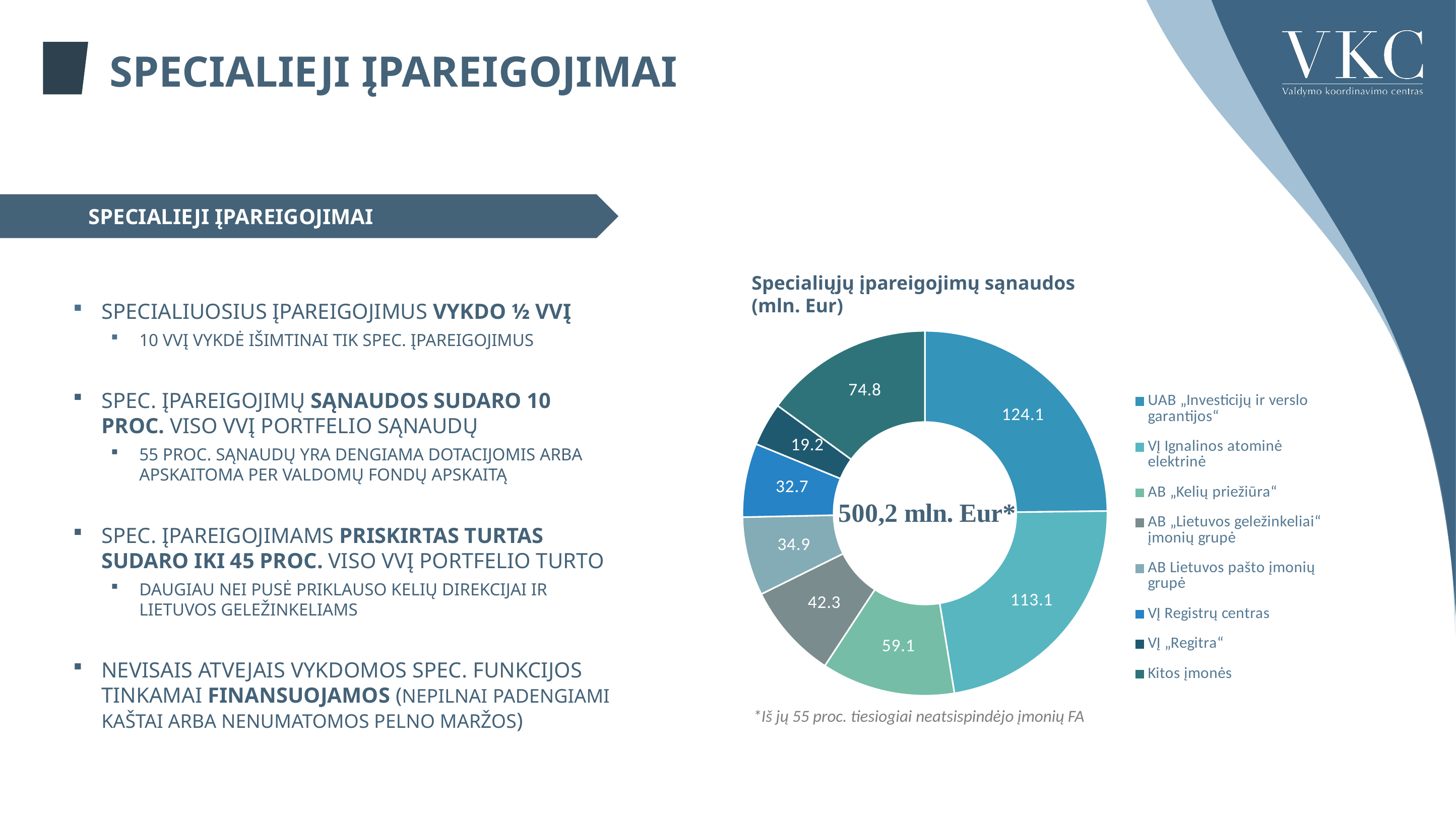
What is the value for VĮ Ignalinos atominė elektrinė? 113.1 What type of chart is shown on the slide? Pie chart (donut) What is the value for AB „Kelių priežiūra“? 59.1 How many categories does the chart show? 8 What is the difference between the values for AB „Lietuvos geležinkeliai“ įmonių grupė and VĮ Registrų centras? 9.6 Which category has the smallest slice? VĮ „Regitra“ What is the title of the chart? Specialiųjų įpareigojimų sąnaudos (mln. Eur) What is the value for VĮ „Regitra“? 19.2 Which is larger, the value for AB Lietuvos pašto įmonių grupė or the value for VĮ Registrų centras? AB Lietuvos pašto įmonių grupė What is the value for Kitos įmonės? 74.8 Which category has the largest slice? UAB „Investicijų ir verslo garantijos“ What is the value for UAB „Investicijų ir verslo garantijos“? 124.1